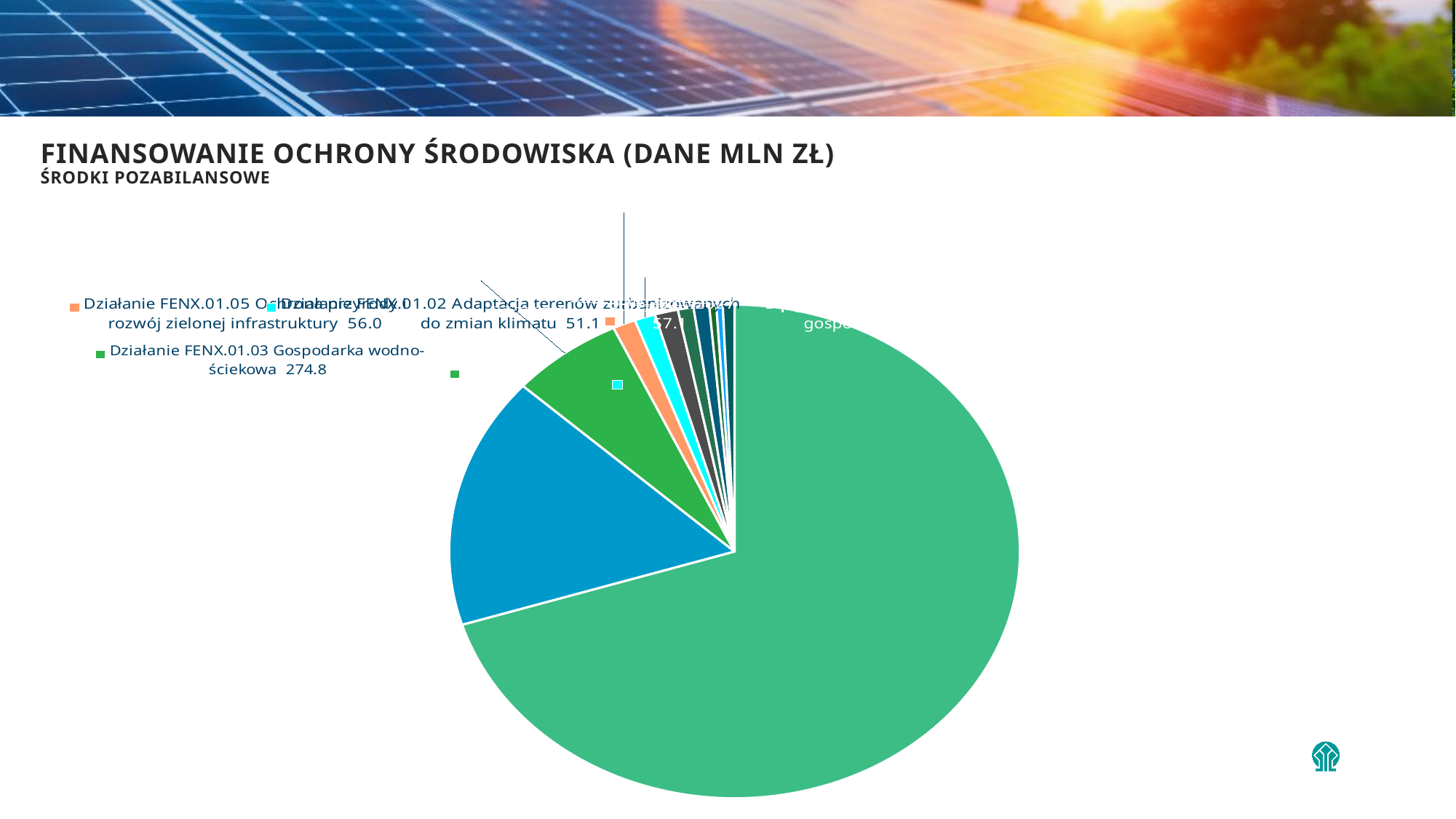
Which is larger: the value for Działanie FENX.01.03 Gospodarka wodno-ściekowa or for Działanie FENX.01.05 Ochrona przyrody i rozwój zielonej infrastruktury? Działanie FENX.01.03 Gospodarka wodno-ściekowa What is the difference between the values for Działanie FENX.01.03 Gospodarka wodno-ściekowa and Działanie FENX.01.05 Ochrona przyrody i rozwój zielonej infrastruktury? 218.8 Which is larger: the value for Działanie FENX.01.05 Ochrona przyrody i rozwój zielonej infrastruktury or for Działanie FENX.01.02 Adaptacja terenów zurbanizowanych do zmian klimatu? Działanie FENX.01.05 Ochrona przyrody i rozwój zielonej infrastruktury What kind of chart is shown on the slide? pie chart What is the value for Działanie FENX.01.05 Ochrona przyrody i rozwój zielonej infrastruktury? 56.0 What is the title of the slide containing the chart? FINANSOWANIE OCHRONY ŚRODOWISKA (DANE MLN ZŁ) What is the value for Działanie FENX.01.03 Gospodarka wodno-ściekowa? 274.8 What is the difference between the values for Działanie FENX.01.05 Ochrona przyrody i rozwój zielonej infrastruktury and Działanie FENX.01.02 Adaptacja terenów zurbanizowanych do zmian klimatu? 4.9 What is the value for Działanie FENX.01.02 Adaptacja terenów zurbanizowanych do zmian klimatu? 51.1 In what unit are the chart's values given, according to the slide title? mln zł What is the difference between the values for Działanie FENX.01.03 Gospodarka wodno-ściekowa and Działanie FENX.01.02 Adaptacja terenów zurbanizowanych do zmian klimatu? 223.7 Of the three labeled actions FENX.01.02, FENX.01.03 and FENX.01.05, which has the highest value? Działanie FENX.01.03 Gospodarka wodno-ściekowa